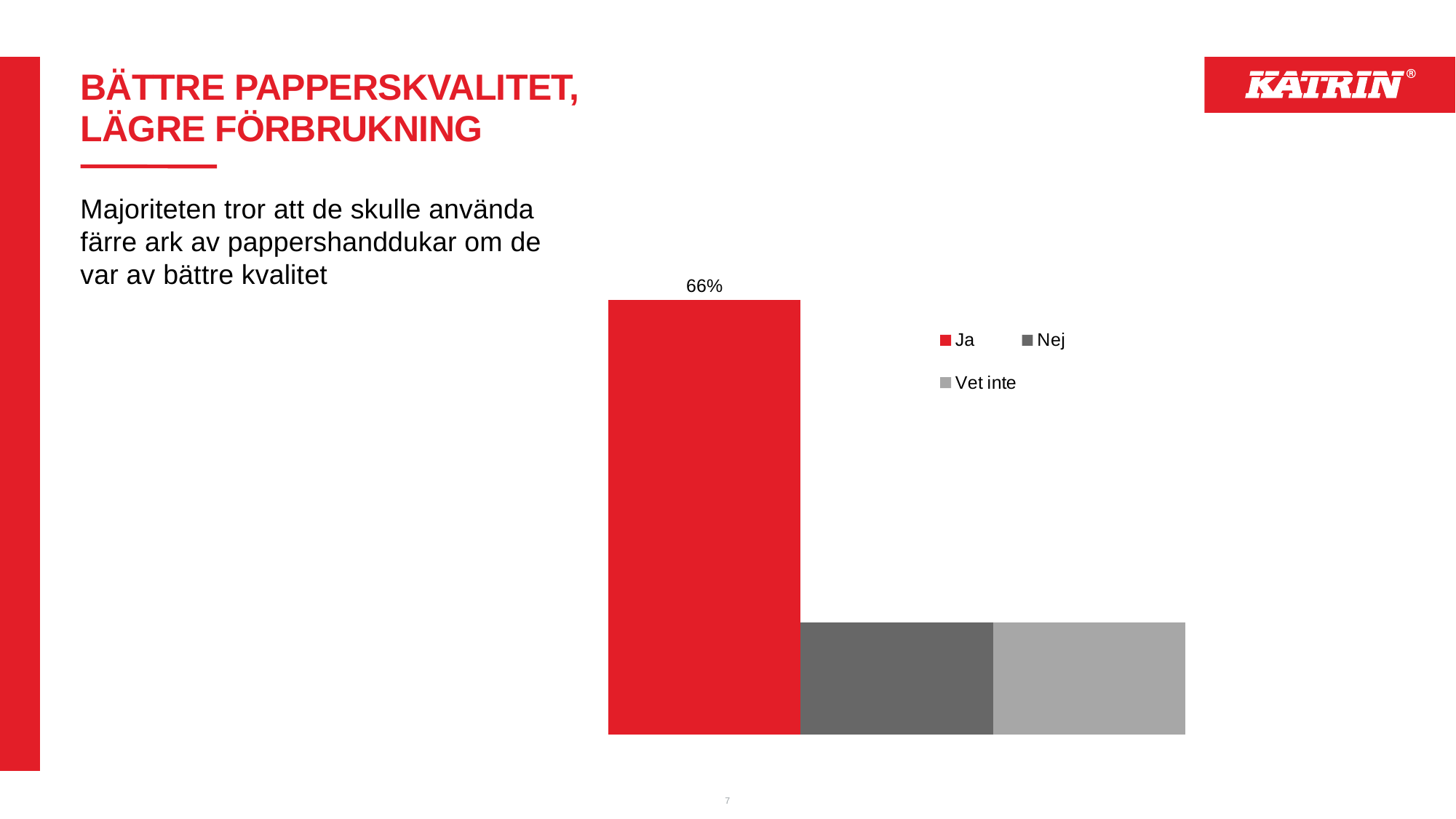
What kind of chart is shown on the slide? Bar chart Which is larger, the value for Ja or the value for Vet inte? Ja What value is shown for the Ja bar? 66% What are the three entries in the chart legend? Ja, Nej, Vet inte How many series does the legend list? 3 What colour is the Ja bar? Red Which is larger, the value for Ja or the value for Nej? Ja Which series has the highest value in the chart? Ja How many bars are plotted in the chart? 3